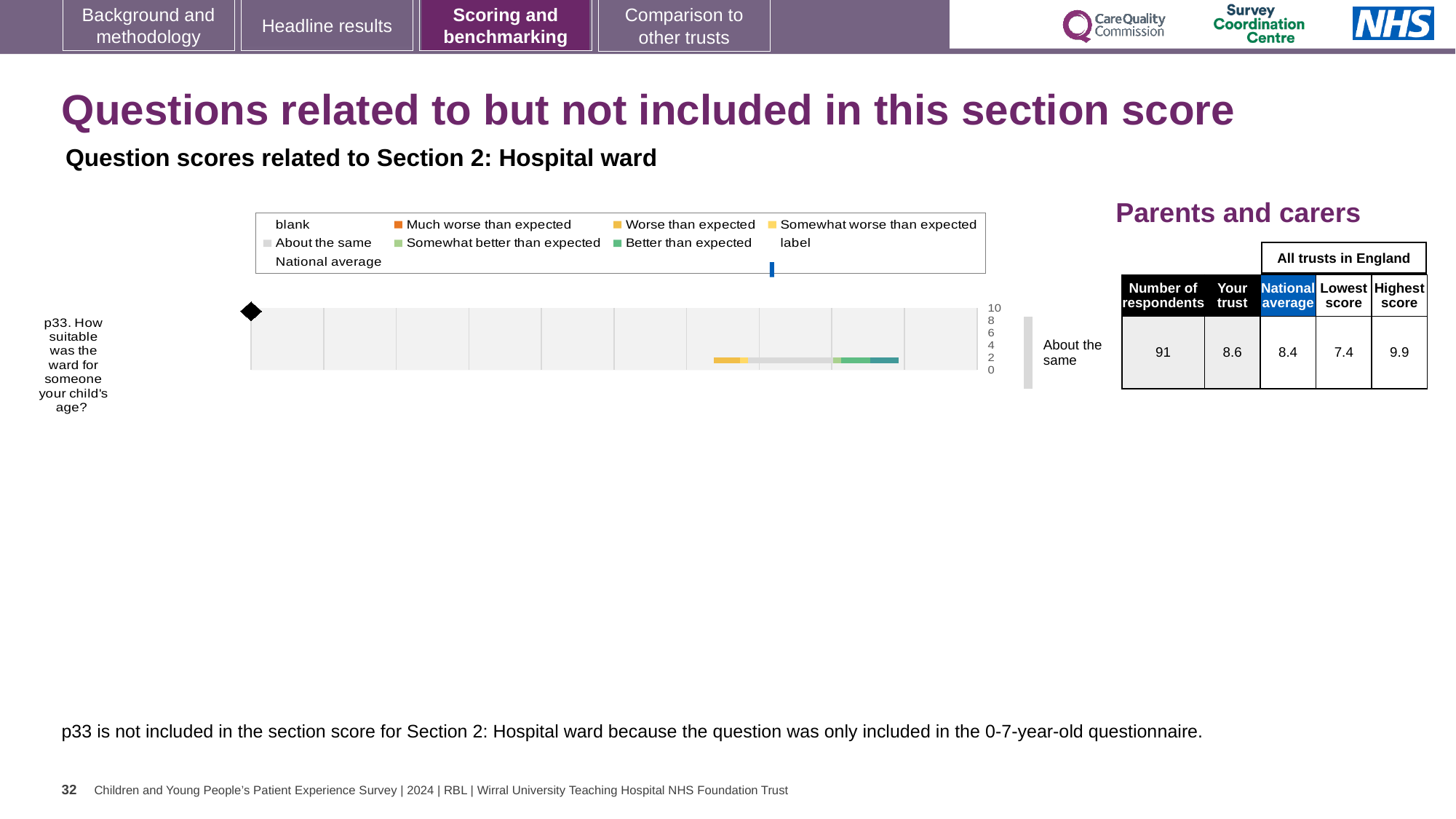
What is the difference between the 'Your trust' score and the national average for p33? 0.2 In the table, what is the national average score for p33? 8.4 Which survey question is plotted in the chart? p33. How suitable was the ward for someone your child's age? What is the difference between the highest score and the lowest score for p33 in the table? 2.5 How many survey questions are plotted in the chart? 1 What kind of chart is shown on the slide? bar chart In the table, what is the lowest score among all trusts in England for p33? 7.4 What benchmark category is shown to the right of the bar for p33? About the same In the table, what is the highest score among all trusts in England for p33? 9.9 In the table, what is the 'Your trust' score for p33? 8.6 In the table, how many respondents answered p33? 91 Which is larger for p33, the 'Your trust' score or the national average? Your trust